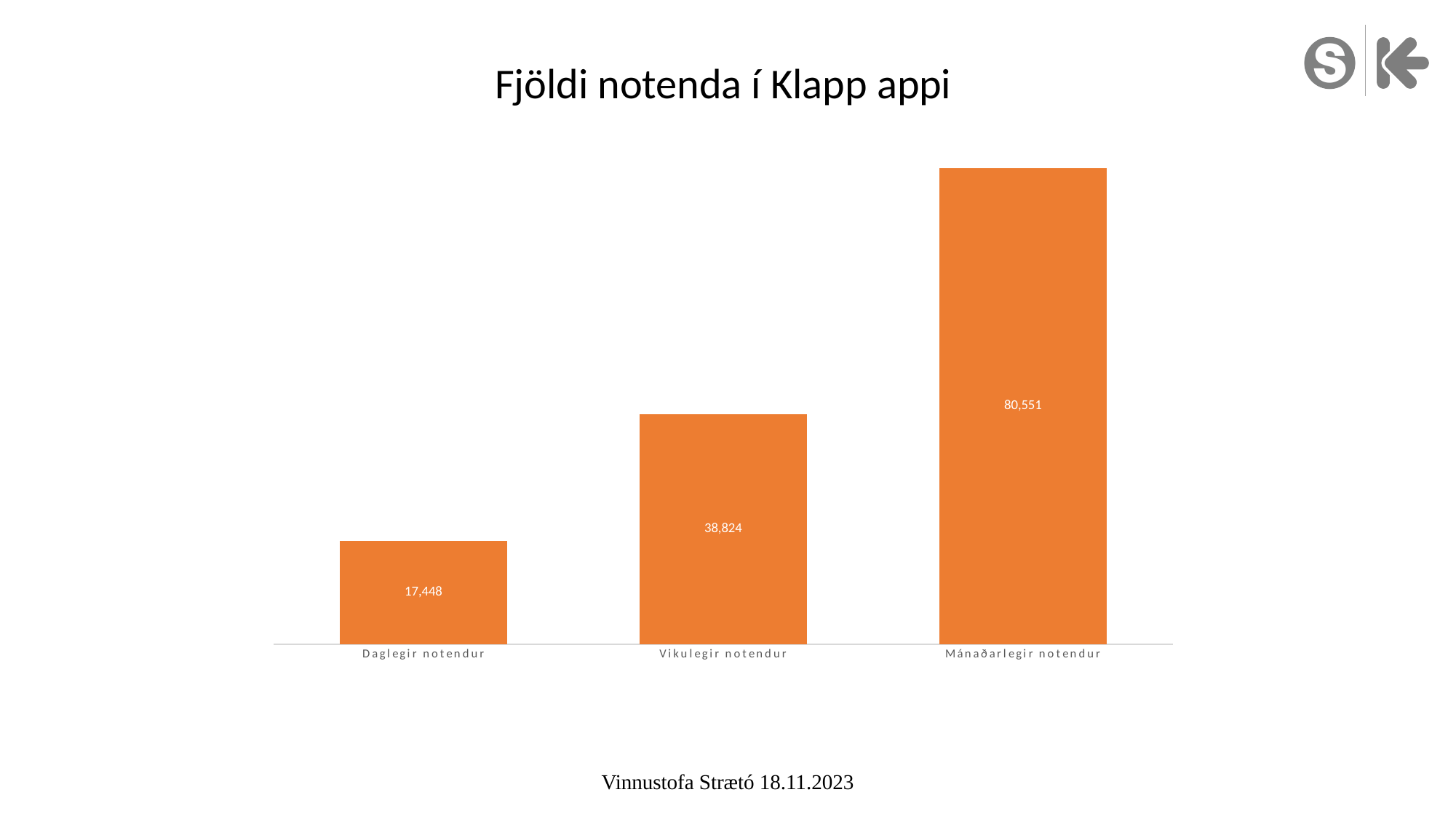
What is the value for Vikulegir notendur? 38,824 What is the value for Mánaðarlegir notendur? 80,551 Which category has the lowest value? Daglegir notendur How many categories are shown in the chart? 3 What is the difference between Mánaðarlegir notendur and Vikulegir notendur? 41,727 Which is larger, Vikulegir notendur or Daglegir notendur? Vikulegir notendur What is the value for Daglegir notendur? 17,448 Which category has the highest value? Mánaðarlegir notendur What kind of chart is shown on the slide? Bar chart Do the values rise or fall from left to right along the x axis? Rise What is the title of the chart? Fjöldi notenda í Klapp appi What is the difference between Vikulegir notendur and Daglegir notendur? 21,376